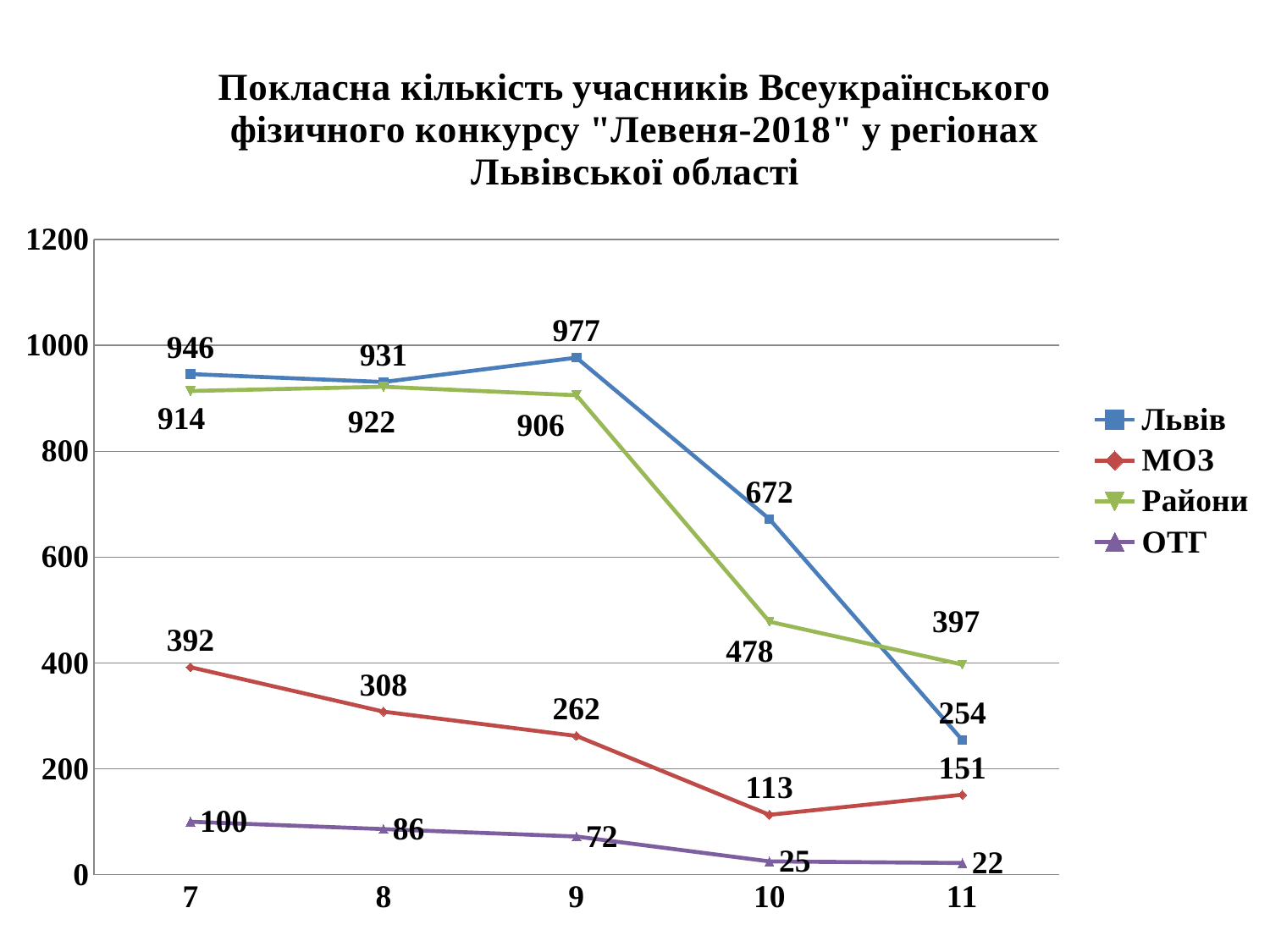
What is the value for Райони in grade 11? 397 What is the value for ОТГ in grade 8? 86 What is the difference between the Львів and Райони values in grade 10? 194 How many grades are shown on the x axis? 5 In which grade is the value for Львів highest? 9 What is the value for Львів in grade 9? 977 Do the values for МОЗ rise or fall from grade 7 to grade 10? fall How many series does the legend list? 4 What is the value for МОЗ in grade 10? 113 What kind of chart is shown on the slide? line chart Which is larger in grade 11: Львів or Райони? Райони In which grade is the value for ОТГ lowest? 11